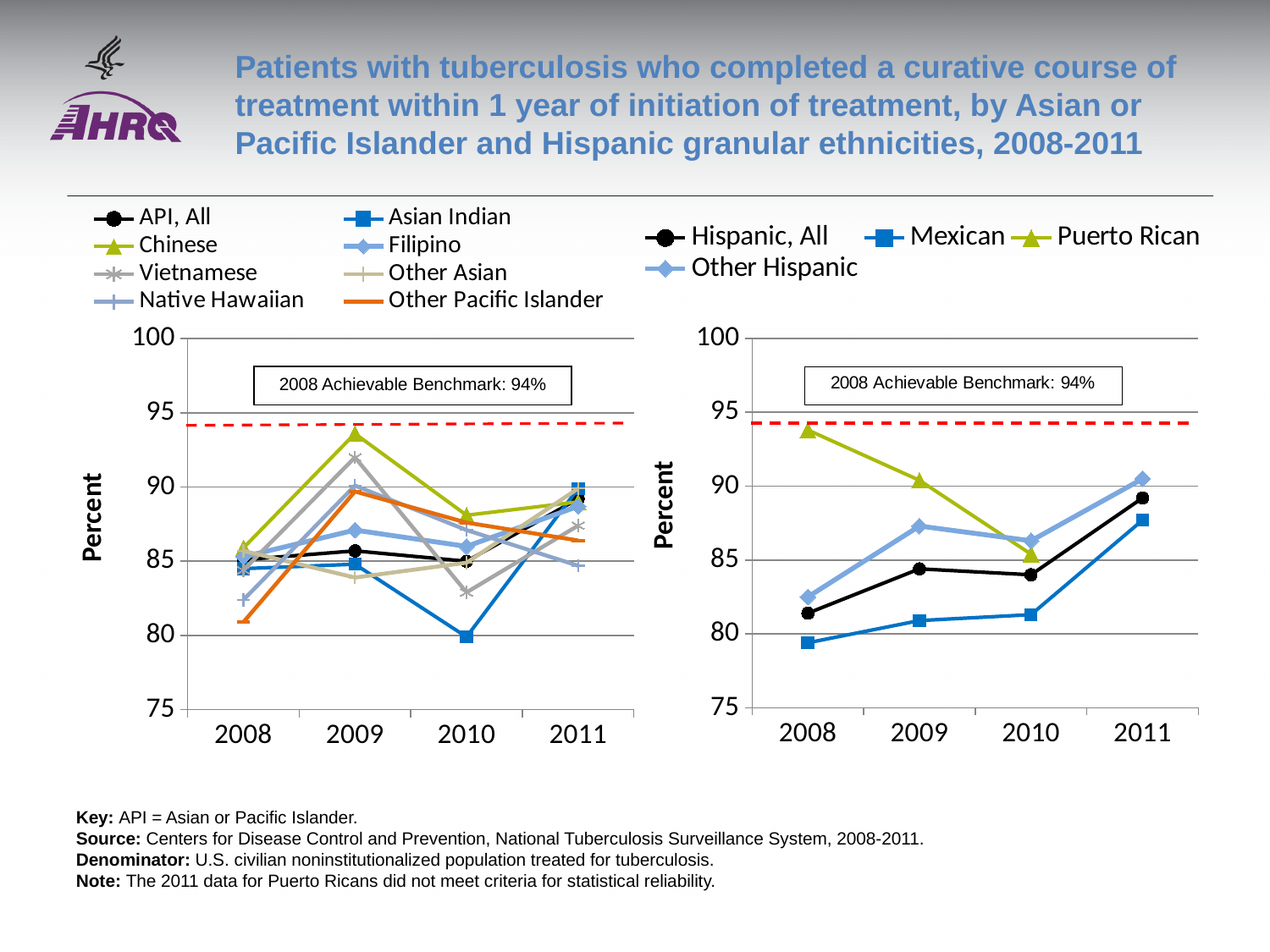
What is the 2008 achievable benchmark shown on both charts? 94% In the right chart (Hispanic ethnicities), which series has the highest value in 2008? Puerto Rican How many series does the legend of the right chart (Hispanic ethnicities) list? 4 In the right chart (Hispanic ethnicities), is the value for Puerto Rican in 2008 greater or less than 90? greater In the right chart (Hispanic ethnicities), does the Puerto Rican series rise or fall from 2008 to 2010? fall What type of chart is the left chart (Asian or Pacific Islander ethnicities)? line chart How many years are shown on the x axis of the right chart (Hispanic ethnicities)? 4 In the right chart (Hispanic ethnicities), is the value for Mexican in 2008 greater or less than 80? less How many series does the legend of the left chart (Asian or Pacific Islander ethnicities) list? 8 In the right chart (Hispanic ethnicities), which series has the lowest value in 2008? Mexican In the left chart (Asian or Pacific Islander ethnicities), which series has the highest value in 2009? Chinese In the left chart (Asian or Pacific Islander ethnicities), is the value for Other Pacific Islander in 2008 greater or less than 85? less